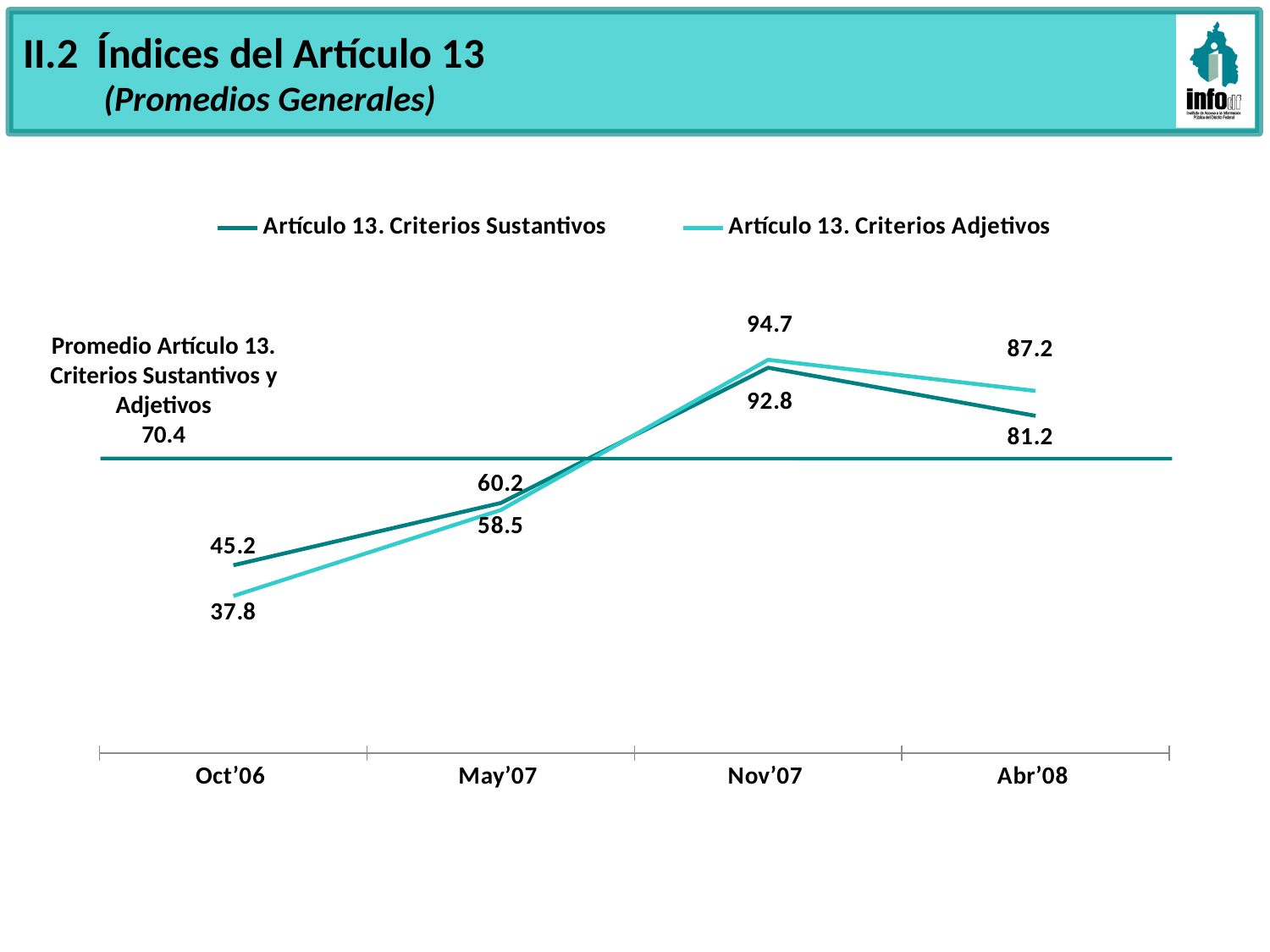
In which period does Artículo 13. Criterios Adjetivos have its lowest value? Oct'06 What is the value of Artículo 13. Criterios Sustantivos in Oct'06? 45.2 What is the value of Artículo 13. Criterios Adjetivos in Nov'07? 94.7 What is the value of Artículo 13. Criterios Adjetivos in Abr'08? 87.2 In which period does Artículo 13. Criterios Sustantivos reach its highest value? Nov'07 How many points are plotted along the x axis for each series? 4 How does Artículo 13. Criterios Adjetivos change from Oct'06 to Nov'07? It rises Which series has the larger value in May'07, Criterios Sustantivos or Criterios Adjetivos? Artículo 13. Criterios Sustantivos What type of chart is shown on the slide? Line chart What value is shown for the horizontal line labelled Promedio Artículo 13. Criterios Sustantivos y Adjetivos? 70.4 How many series does the legend list? 2 What is the difference between Artículo 13. Criterios Adjetivos and Artículo 13. Criterios Sustantivos in Abr'08? 6